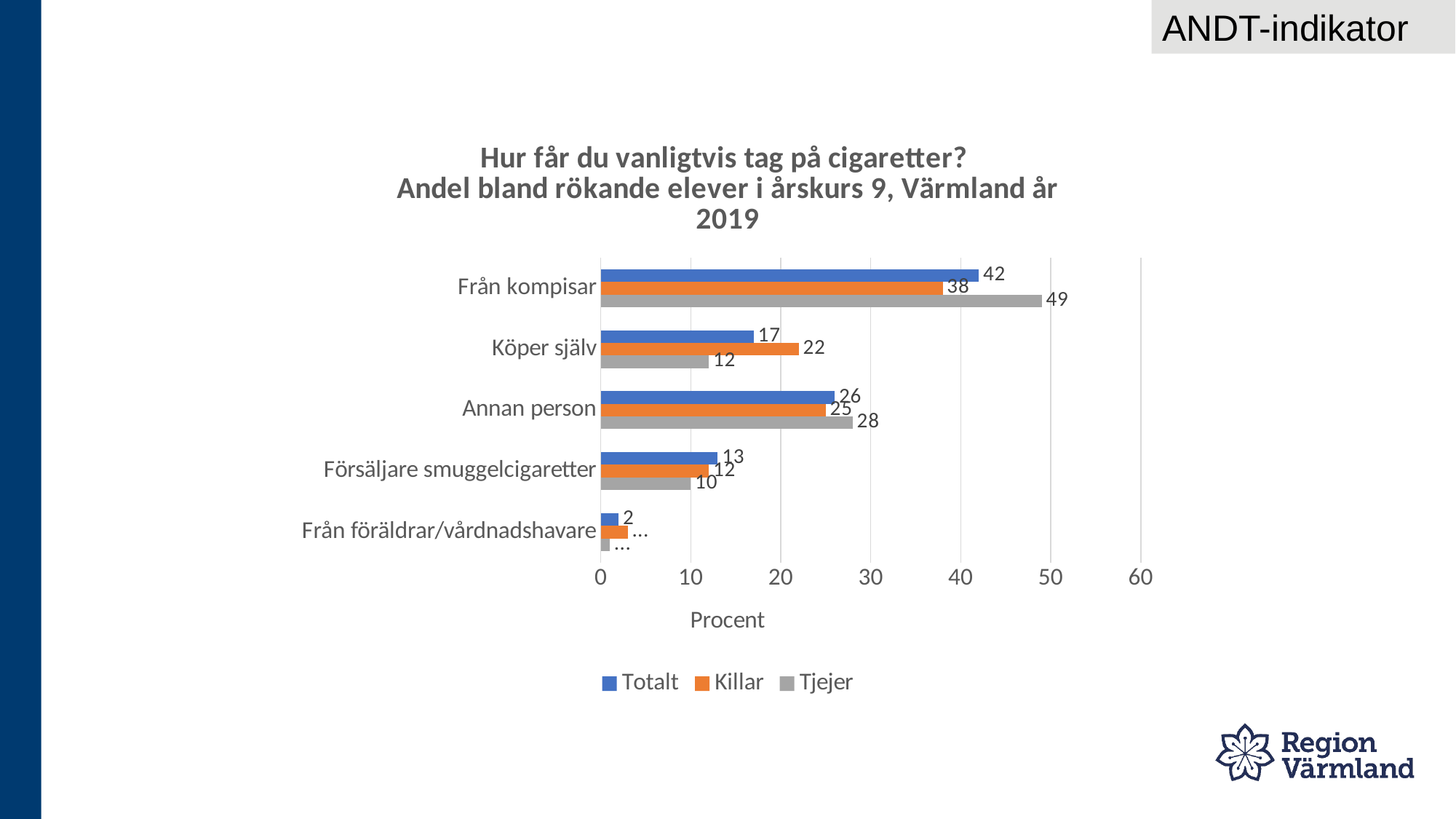
How many series does the legend list? 3 Is the Totalt value for Från kompisar greater or less than 40? greater Which category has the lowest Tjejer value? Från föräldrar/vårdnadshavare What is the Totalt value for Från föräldrar/vårdnadshavare? 2 Which category has the highest Totalt value? Från kompisar How many categories are shown on the y axis? 5 For Köper själv, which is larger: the Killar value or the Tjejer value? Killar What kind of chart is shown on the slide? Bar chart What is the difference between the Tjejer and Killar values for Från kompisar? 11 What is the Totalt value for Annan person? 26 What is the Tjejer value for Från kompisar? 49 What is the Killar value for Köper själv? 22